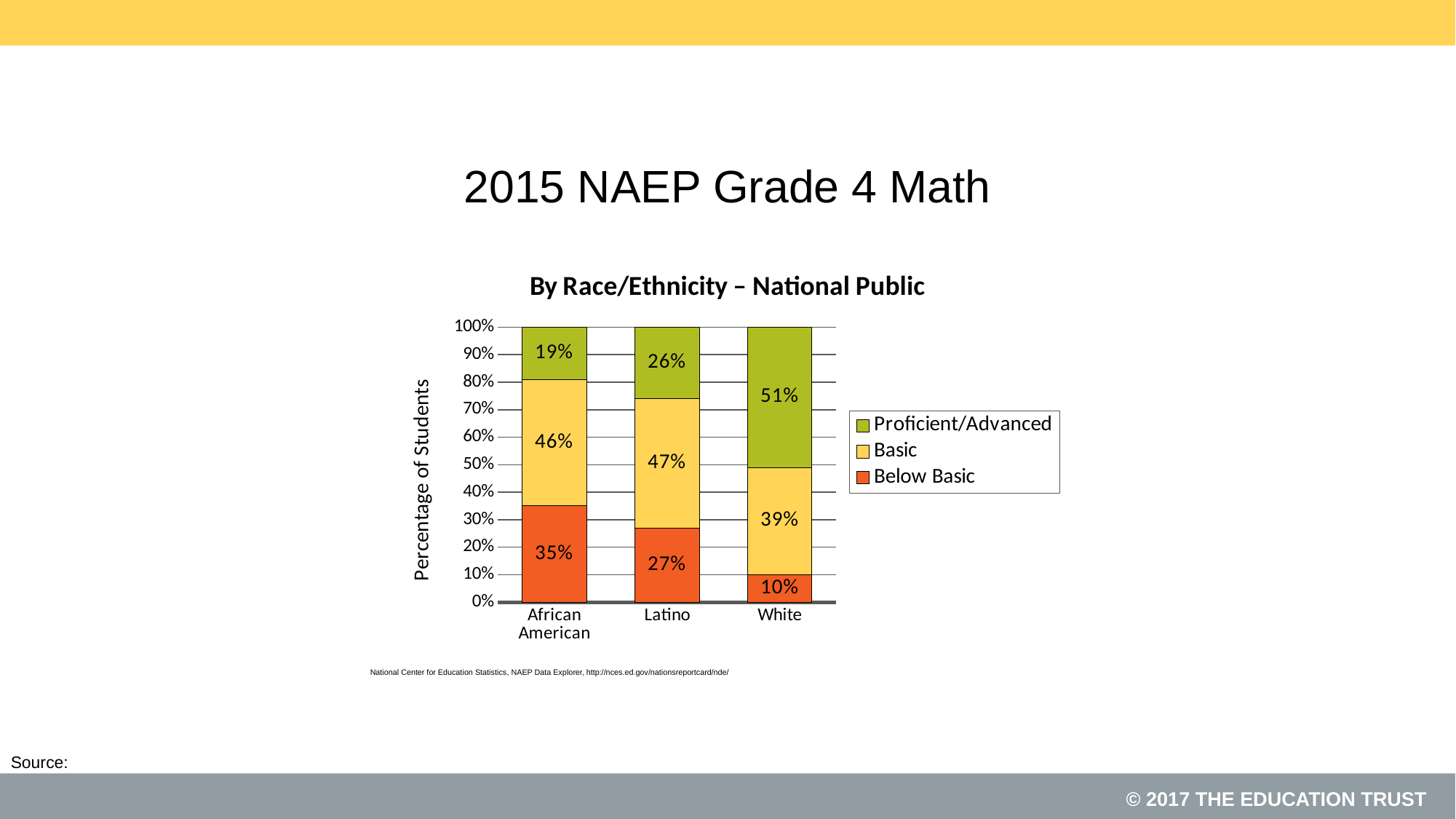
Which race/ethnicity group has the lowest Below Basic percentage? White What is the combined percentage of Basic and Proficient/Advanced for Latino students? 73% How many race/ethnicity categories are shown on the x axis? 3 How many series does the legend list? 3 What is the difference between the Below Basic percentage for African American students and for White students? 25% What is the label on the y axis of the chart? Percentage of Students What percentage of Latino students scored Basic? 47% What percentage of African American students scored Below Basic? 35% Which race/ethnicity group has the highest Proficient/Advanced percentage? White Which is larger: the Proficient/Advanced percentage for Latino students or for African American students? Latino What percentage of White students scored Proficient/Advanced? 51% What kind of chart is shown on the slide? Stacked bar chart